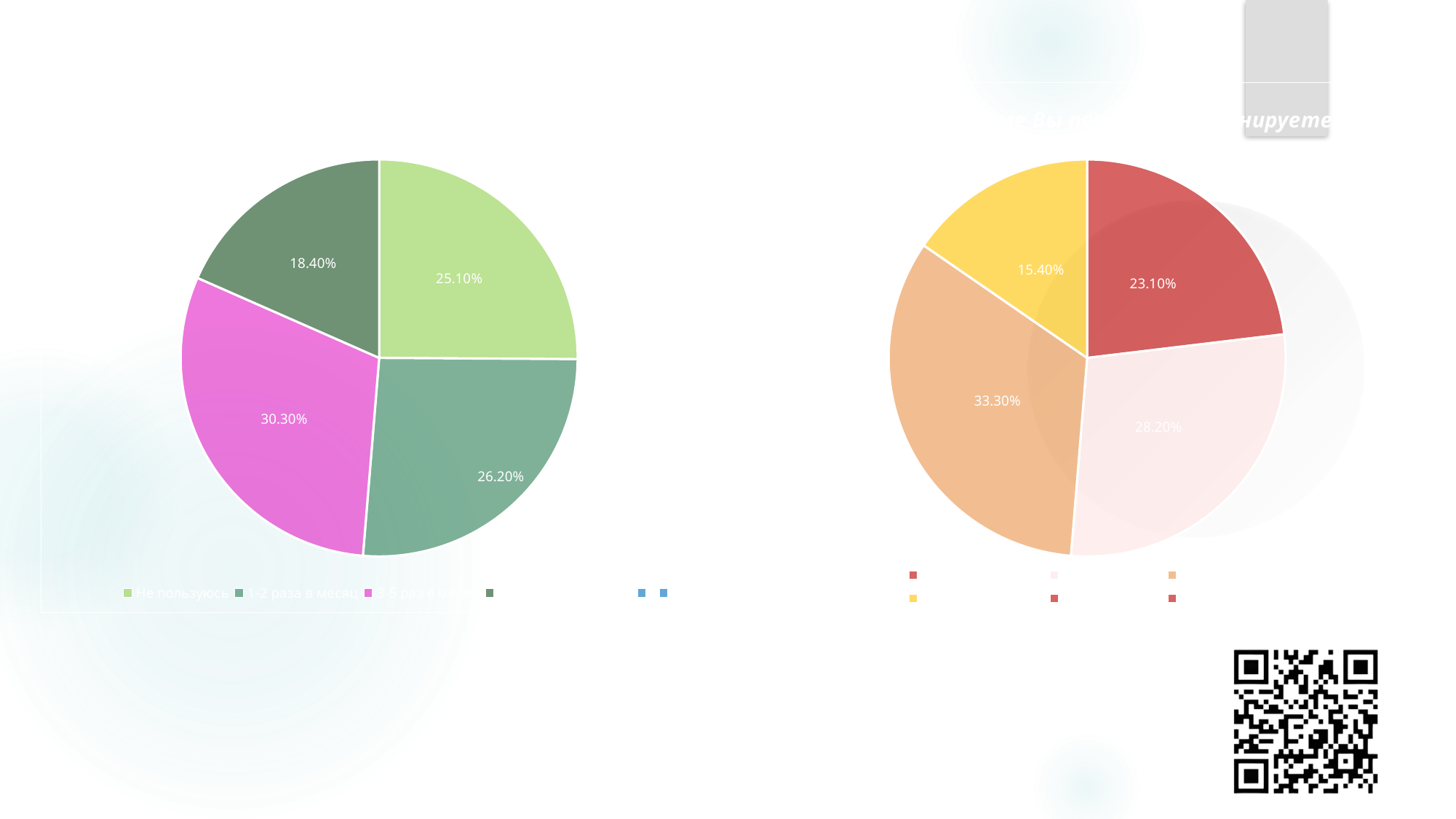
In the left pie chart, what is the difference between the pink slice (30.30%) and the dark green slice (18.40%)? 11.90% In the left pie chart, what is the value of the smallest slice? 18.40% In the left pie chart, what is the value of the largest slice? 30.30% In the right pie chart, which is larger: the red slice or the light pink slice? the light pink slice (28.20%) How many slices does the left pie chart have? 4 What kind of chart is the chart on the left of the slide? pie chart In the right pie chart, what is the value of the largest slice? 33.30% In the right pie chart, what is the value of the smallest slice? 15.40% In the left pie chart, what share does the slice labelled "Не пользуюсь" (light green) have? 25.10% How many slices does the right pie chart have? 4 In the left pie chart, what share does the slice labelled "1-2 раза в месяц" have? 26.20% What kind of chart is the chart on the right of the slide? pie chart